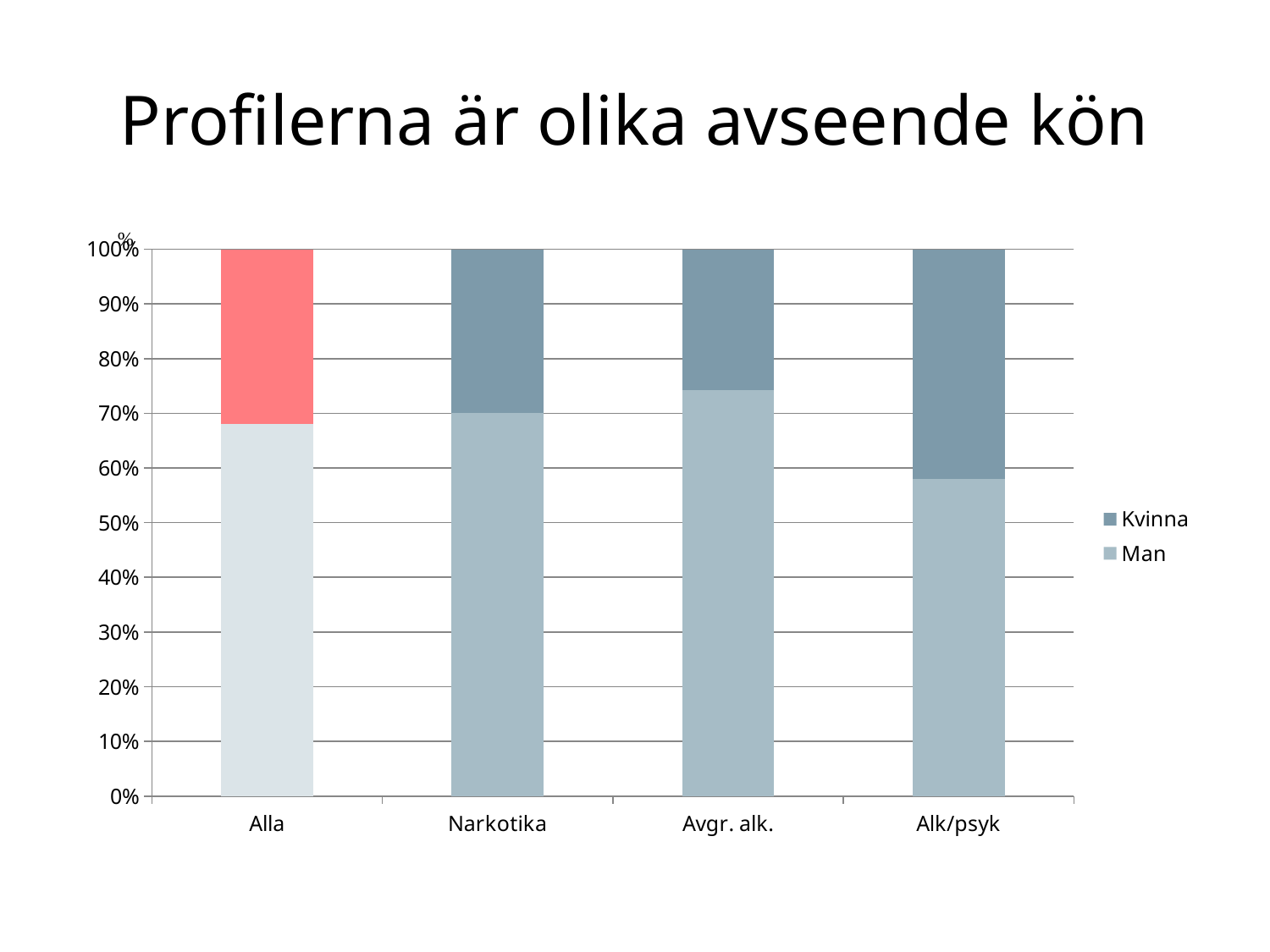
How many series does the legend list? 2 Is the Man share larger for Narkotika or for Alk/psyk? Narkotika What is the total height of each stacked bar? 100% Which category has the largest Kvinna share? Alk/psyk Is the Kvinna share for Avgr. alk. greater or less than 30%? less Which category has the smallest Man share? Alk/psyk Which series are listed in the legend? Kvinna and Man Which category has the largest Man share? Avgr. alk. Is the Man share for Avgr. alk. greater or less than 70%? greater How many categories are shown on the x axis? 4 What kind of chart is shown on the slide? Stacked bar chart Is the Man share for Alk/psyk greater or less than 60%? less